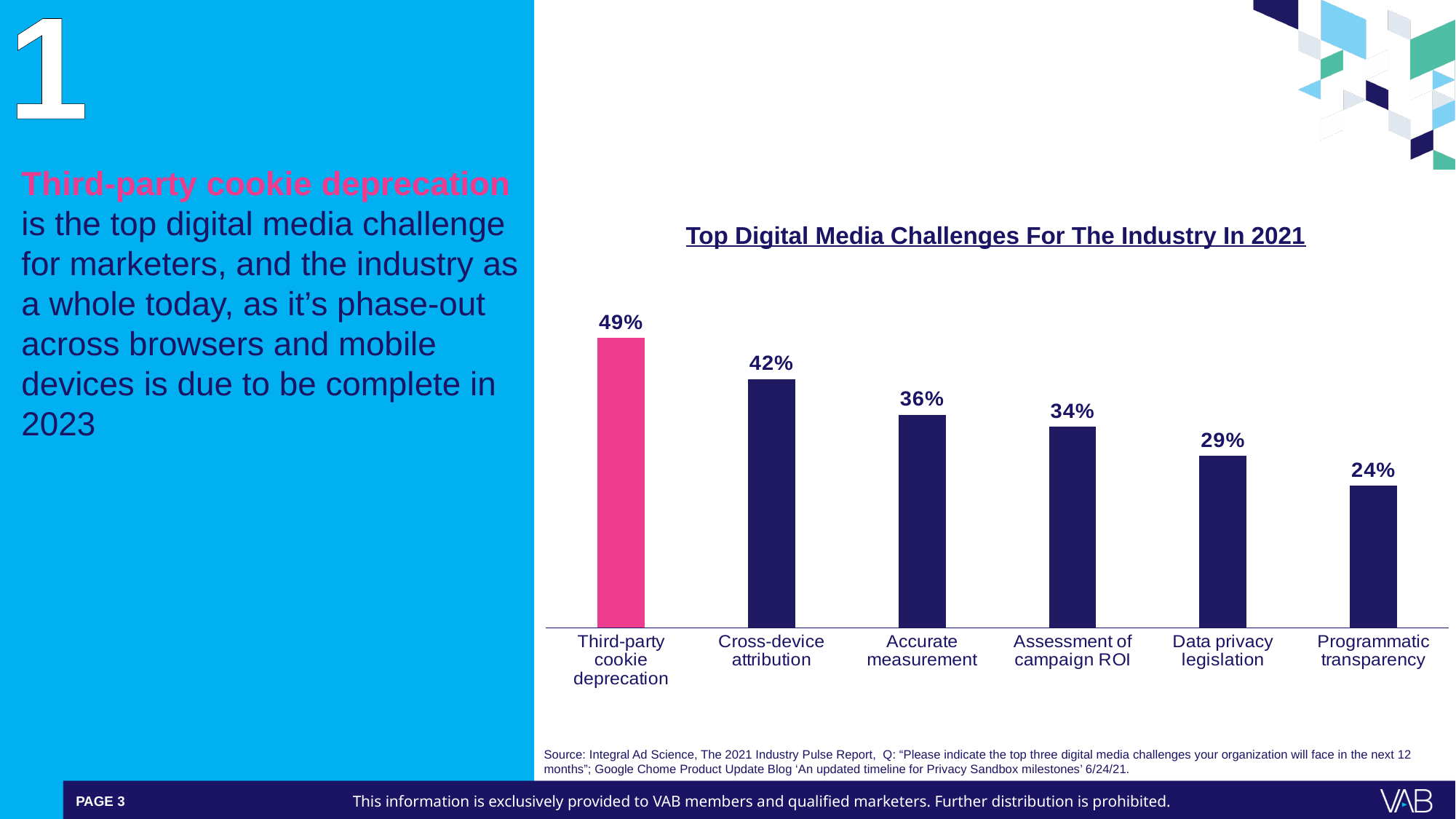
Which category has the highest value? Third-party cookie deprecation What is the difference between the values for Third-party cookie deprecation and Cross-device attribution? 7% Which category has the lowest value? Programmatic transparency What is the value for Programmatic transparency? 24% What is the value for Third-party cookie deprecation? 49% What kind of chart is shown on the slide? Bar chart What is the value for Data privacy legislation? 29% What is the difference between the values for Accurate measurement and Assessment of campaign ROI? 2% What is the title of the chart? Top Digital Media Challenges For The Industry In 2021 What is the value for Cross-device attribution? 42% Which is larger, the value for Accurate measurement or the value for Data privacy legislation? Accurate measurement How many categories are shown in the chart? 6